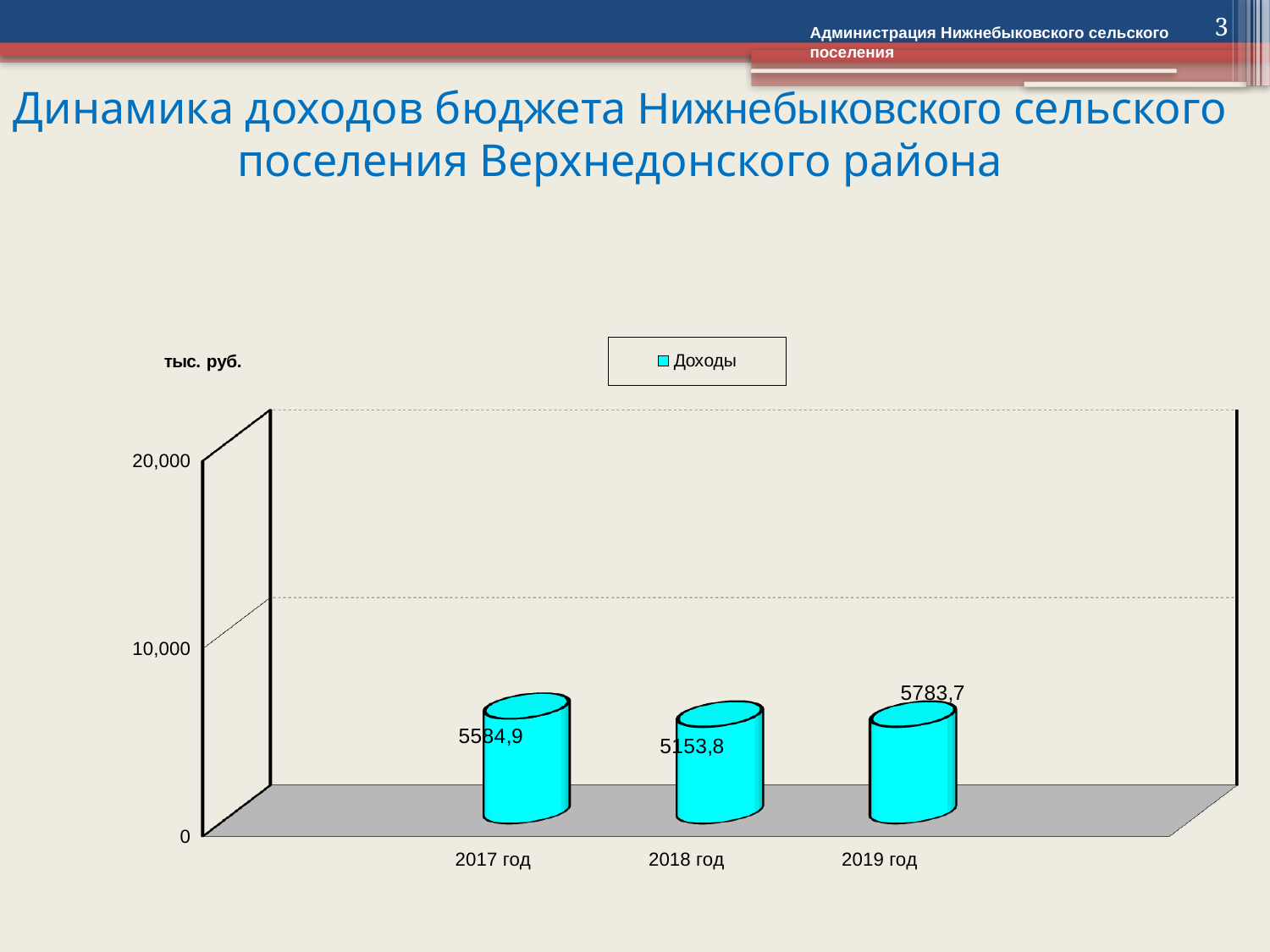
What is the value for 2018 год? 5153,8 Which year has the lowest value? 2018 год How many series does the legend list? 1 What unit is shown above the vertical axis? тыс. руб. Which is larger, the value for 2018 год or the value for 2019 год? 2019 год Is the value for 2019 год greater or less than 10,000? less How many years are shown on the x axis? 3 What kind of chart is shown on the slide? bar chart What is the value for 2019 год? 5783,7 What is the name of the series in the legend? Доходы What is the difference between the values for 2019 год and 2018 год? 629,9 Which year has the highest value? 2019 год